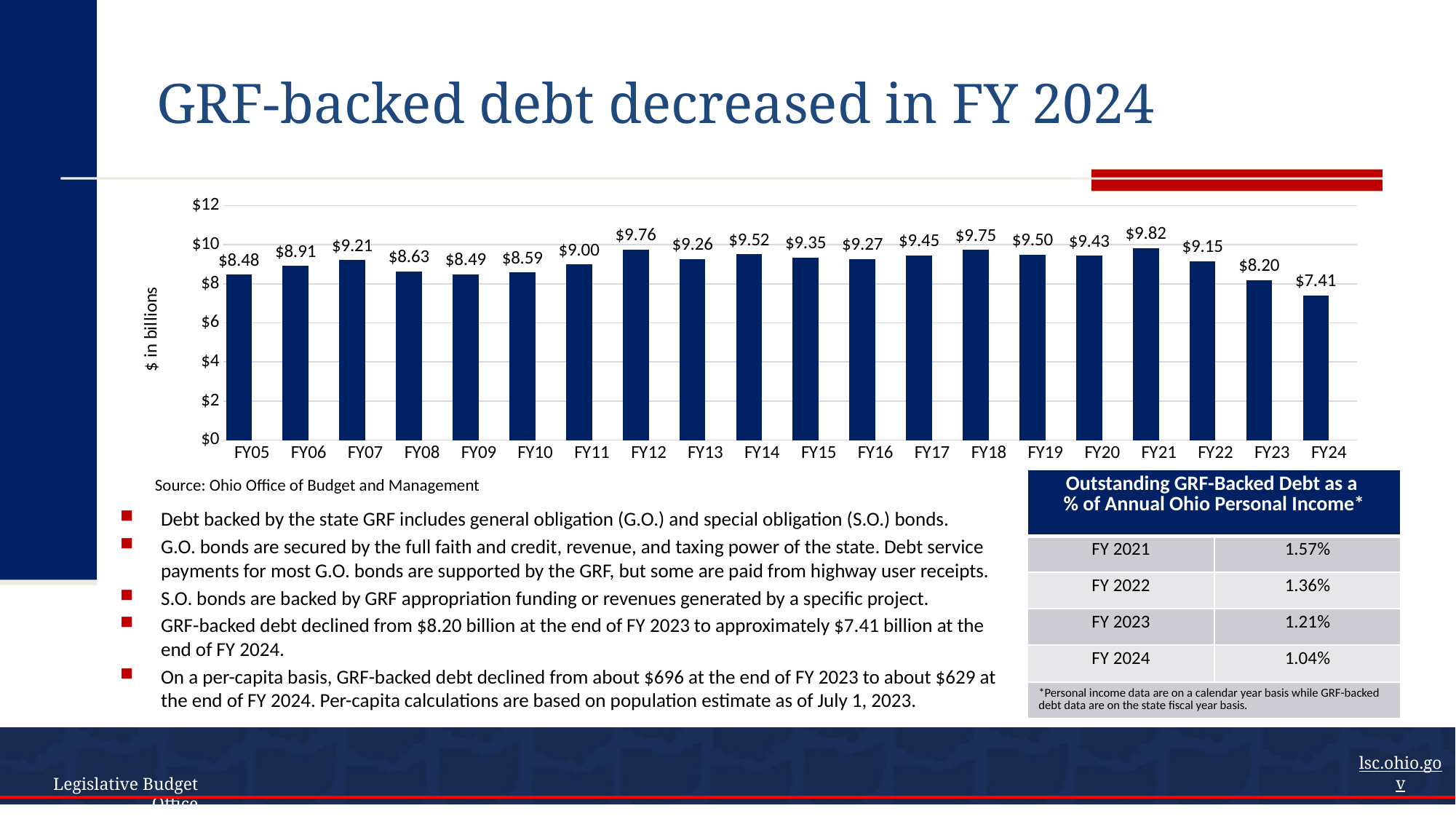
What is the value for FY12? $9.76 How many fiscal years are shown on the x axis? 20 What is the source cited below the chart? Ohio Office of Budget and Management What is the label of the y axis? $ in billions What is the value for FY24? $7.41 Do the values rise or fall from FY21 to FY24? fall Is the value for FY18 greater or less than $8? greater Which fiscal year has the lowest value? FY24 Which fiscal year has the highest value? FY21 Which is larger, the value for FY07 or the value for FY08? FY07 What is the difference between the values for FY23 and FY24? $0.79 What kind of chart is shown on the slide? bar chart